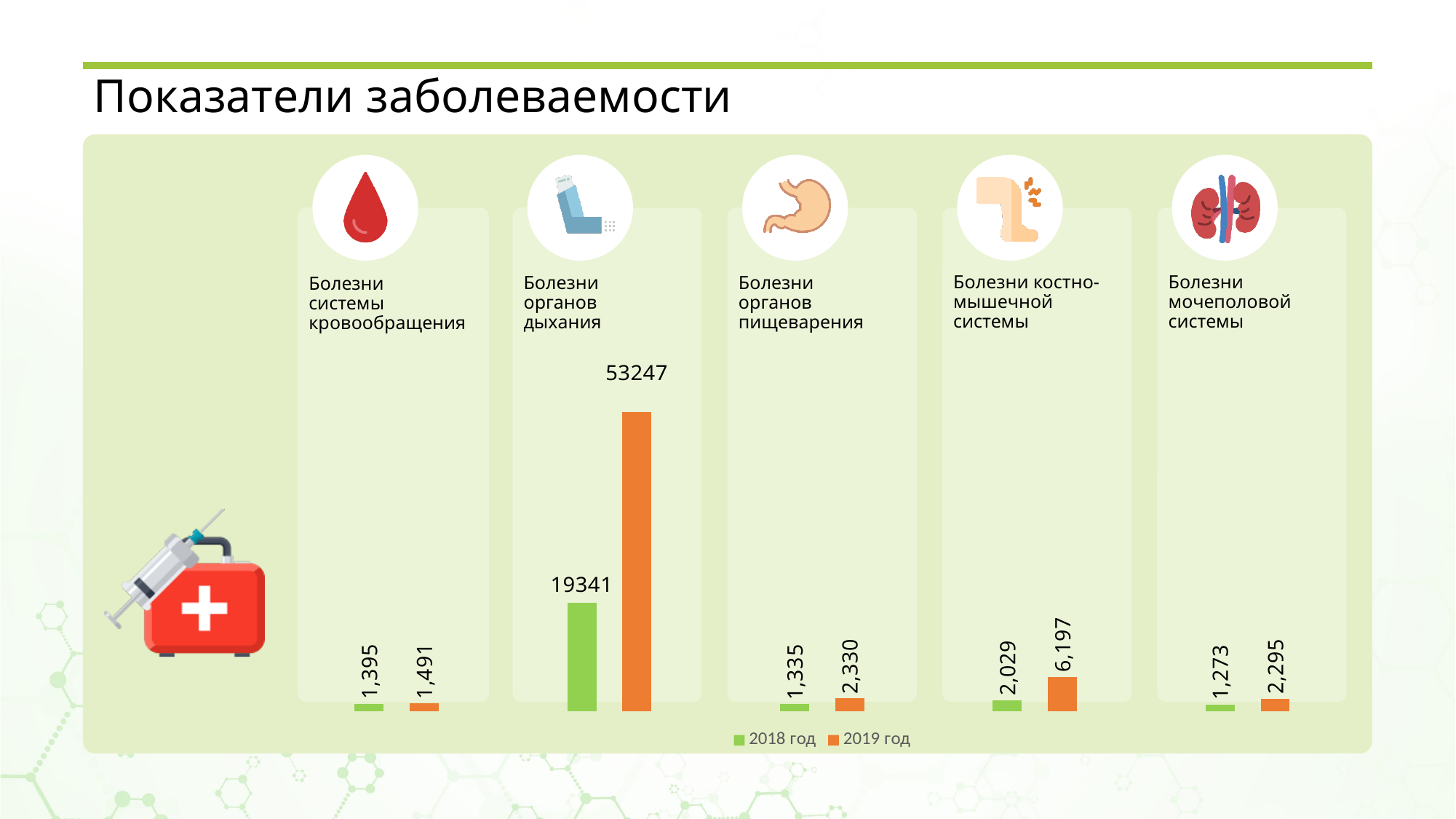
Which is larger: the 2019 год value for Болезни органов пищеварения or the 2019 год value for Болезни мочеполовой системы? Болезни органов пищеварения How many series does the legend list? 2 Which category has the highest 2019 год value? Болезни органов дыхания How many disease categories are shown in the chart? 5 What is the 2018 год value for Болезни системы кровообращения? 1,395 What is the difference between the 2019 год and 2018 год values for Болезни органов дыхания? 33906 What is the 2018 год value for Болезни костно-мышечной системы? 2,029 What is the 2019 год value for Болезни органов дыхания? 53247 What is the 2019 год value for Болезни мочеполовой системы? 2,295 What is the difference between the 2019 год and 2018 год values for Болезни костно-мышечной системы? 4,168 What kind of chart is shown on the slide? Bar chart Which category has the lowest 2018 год value? Болезни мочеполовой системы